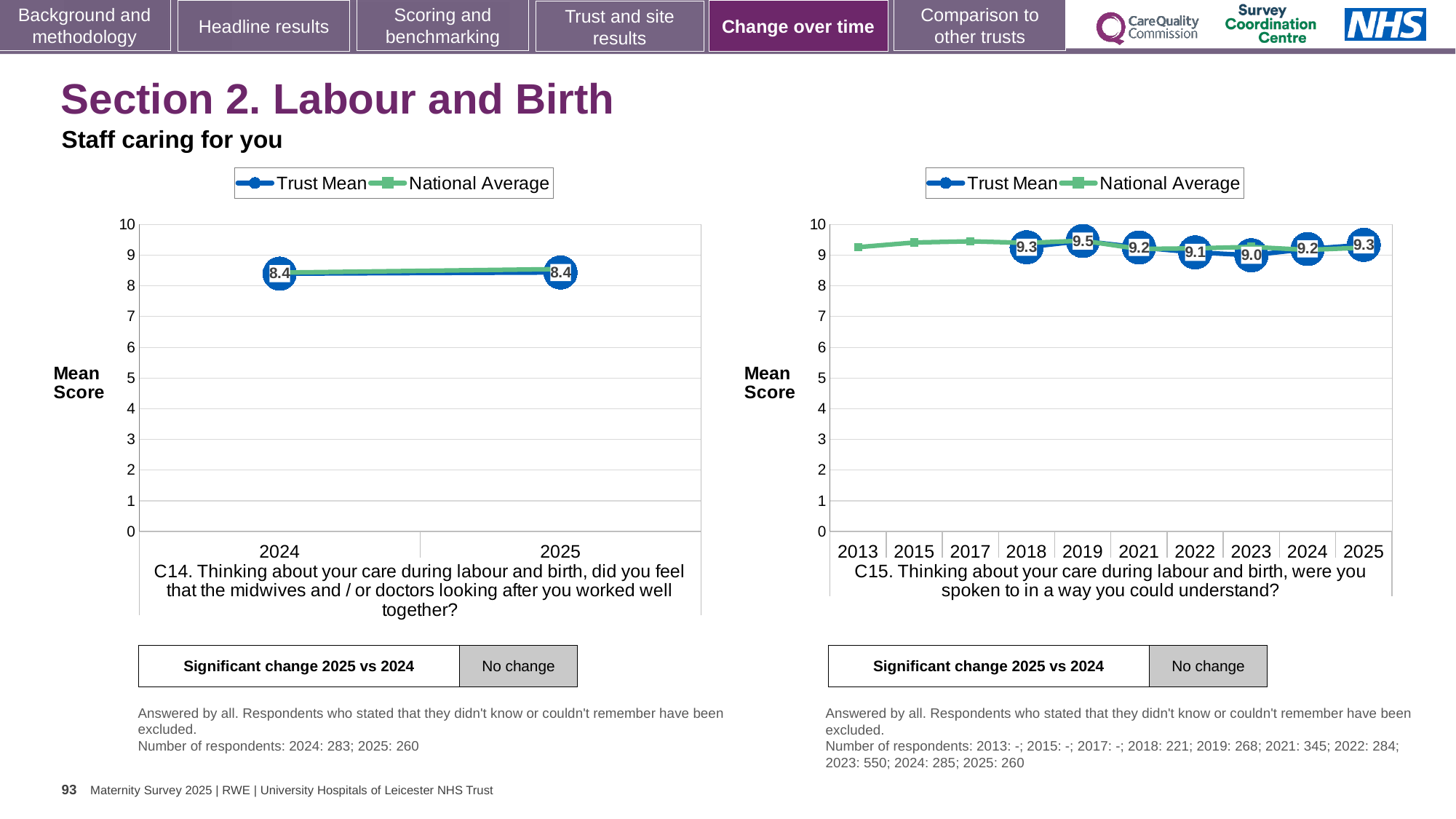
In the right chart (C15), what is the Trust Mean for 2025? 9.3 How many series does the legend of the left chart (C14) list? 2 In the left chart (C14), what is the difference between the Trust Mean in 2025 and in 2024? 0.0 In the right chart (C15), which year has the lowest labelled Trust Mean? 2023 In the right chart (C15), what is the Trust Mean for 2019? 9.5 In the right chart (C15), what is the Trust Mean for 2023? 9.0 In the right chart (C15), what is the difference between the Trust Mean in 2019 and in 2023? 0.5 In the right chart (C15), which year has the highest Trust Mean? 2019 In the left chart (C14), what is the Trust Mean for 2025? 8.4 In the left chart (C14), what is the Trust Mean for 2024? 8.4 What type of chart is the right chart (C15)? Line chart In the right chart (C15), how many years are shown on the x axis? 10